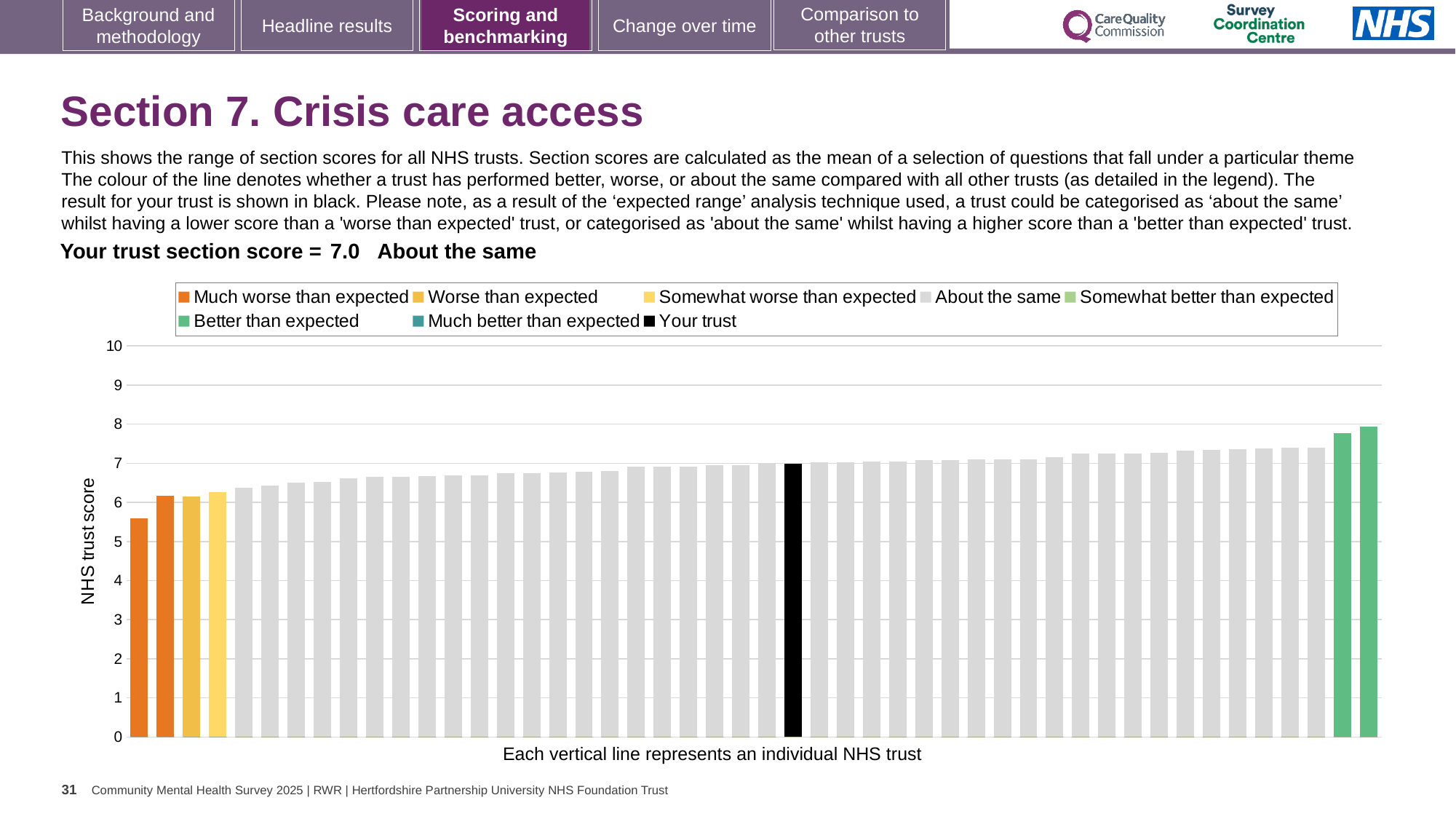
Is the value of the rightmost (highest) bar greater or less than 7? greater Do the bar values rise or fall from left to right along the x axis? Rise What colour is the bar representing your trust? Black What is the section score for your trust shown on the slide? 7.0 Is the value of the leftmost (lowest) bar greater or less than 6? less Is the value of the black 'Your trust' bar greater or less than 5? greater What is the label on the y axis of the chart? NHS trust score Which category is your trust placed in for Section 7 Crisis care access? About the same How many entries does the chart legend list? 8 Which is larger, the leftmost bar or the rightmost bar? The rightmost bar What kind of chart is shown on the slide? Bar chart How many bars are coloured green (better than expected)? 2